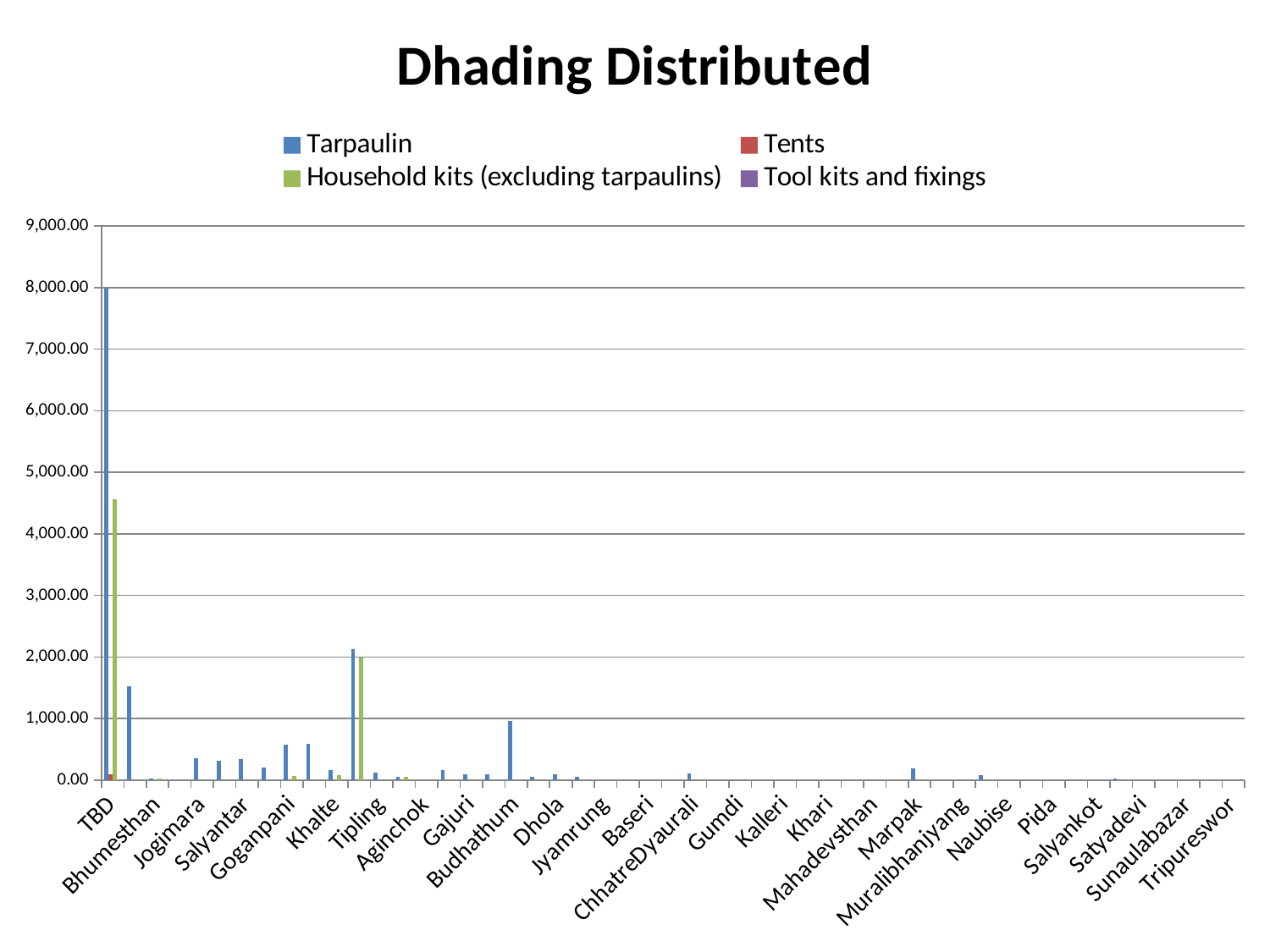
Is the Tarpaulin value for Tipling greater or less than 2,000.00? less What kind of chart is shown on the slide? bar chart Which is larger, the Tarpaulin value for Tipling or the Tarpaulin value for Budhathum? Budhathum Is the Household kits (excluding tarpaulins) value for TBD greater or less than 4,000.00? greater Is the Tarpaulin value for TBD greater or less than 7,000.00? greater Which category has the highest Tarpaulin value? TBD How many series does the legend list? 4 What is the title of the chart? Dhading Distributed Which is larger, the Tarpaulin value for TBD or the Tarpaulin value for Tipling? TBD What colour represents the Household kits (excluding tarpaulins) series in the legend? green